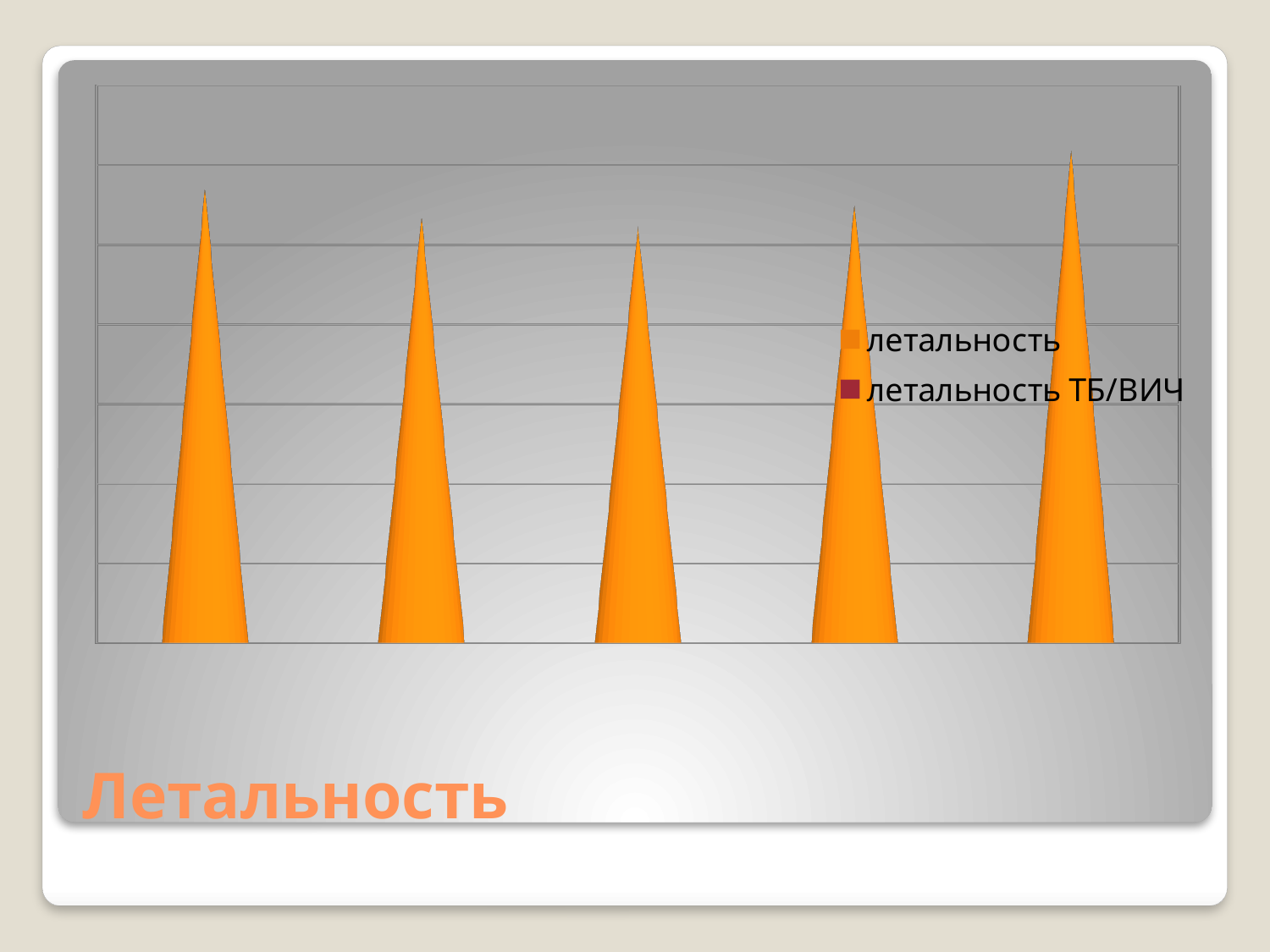
What is the title of the chart? Летальность Which is taller, the leftmost bar or the rightmost bar? the rightmost bar Which bar is the shortest on the chart, counting from the left? the third (middle) bar Do the bar heights rise steadily from left to right across the chart? no How many series does the legend list? 2 What are the two series named in the legend? летальность; летальность ТБ/ВИЧ How many bars are plotted on the chart? 5 Which is taller, the third bar or the fourth bar from the left? the fourth bar Which is taller, the first bar or the second bar from the left? the first bar What kind of chart is shown on the slide? bar chart Which bar is the tallest on the chart, counting from the left? the fifth (rightmost) bar